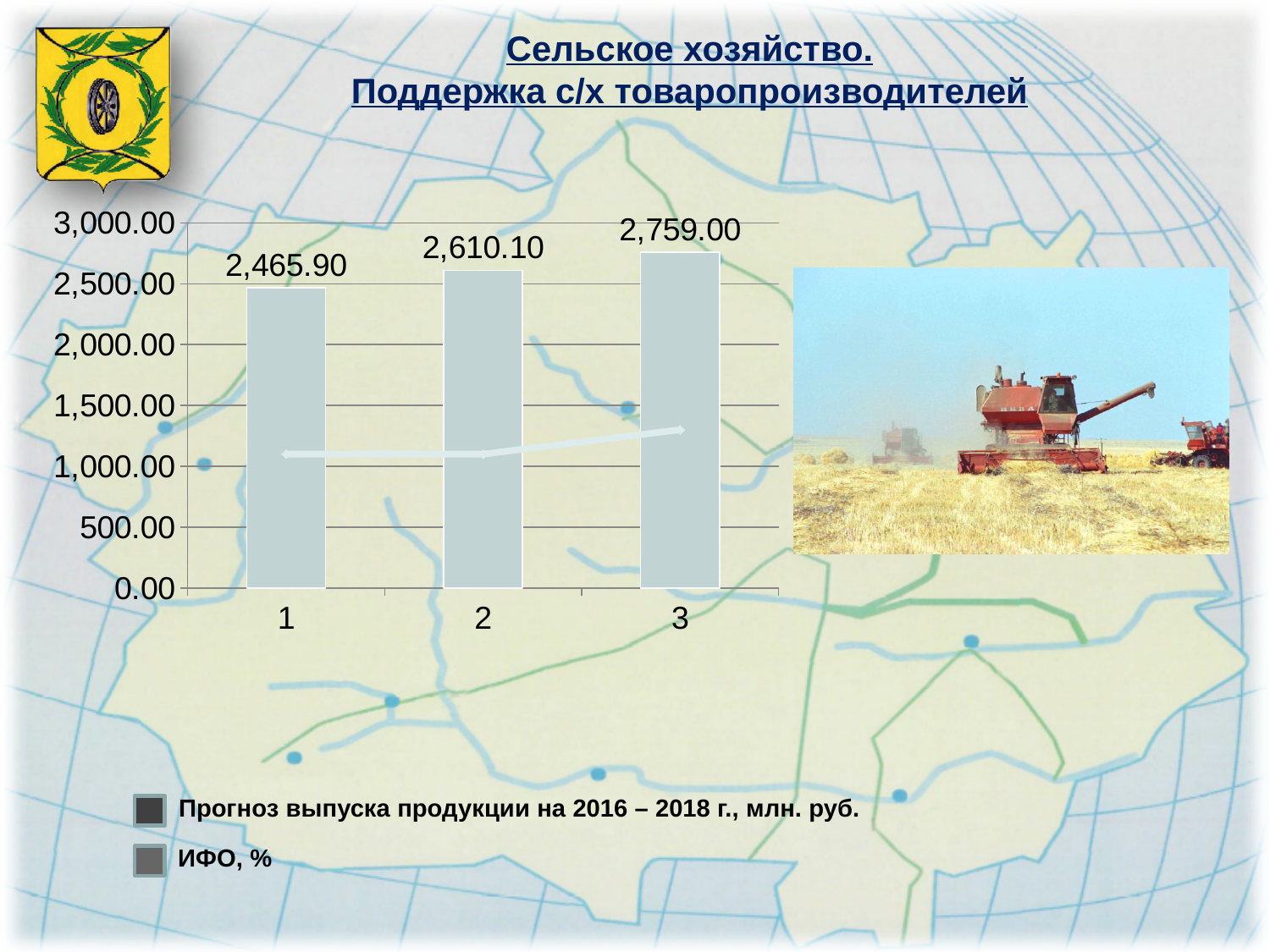
What is the value of the bar for category 1? 2,465.90 What is the value of the bar for category 3? 2,759.00 What is the value of the bar for category 2? 2,610.10 Which category has the lowest bar value? 1 Which is larger, the bar value for category 2 or for category 3? 3 How many bars are plotted in the chart? 3 What is the difference between the bar values for category 3 and category 1? 293.10 Is the bar value for category 1 greater or less than 2,500.00? less What unit is given in the legend for the forecast of product output? млн. руб. What is the difference between the bar values for category 2 and category 1? 144.20 Do the bar values rise or fall from category 1 to category 3? rise Which category has the highest bar value? 3